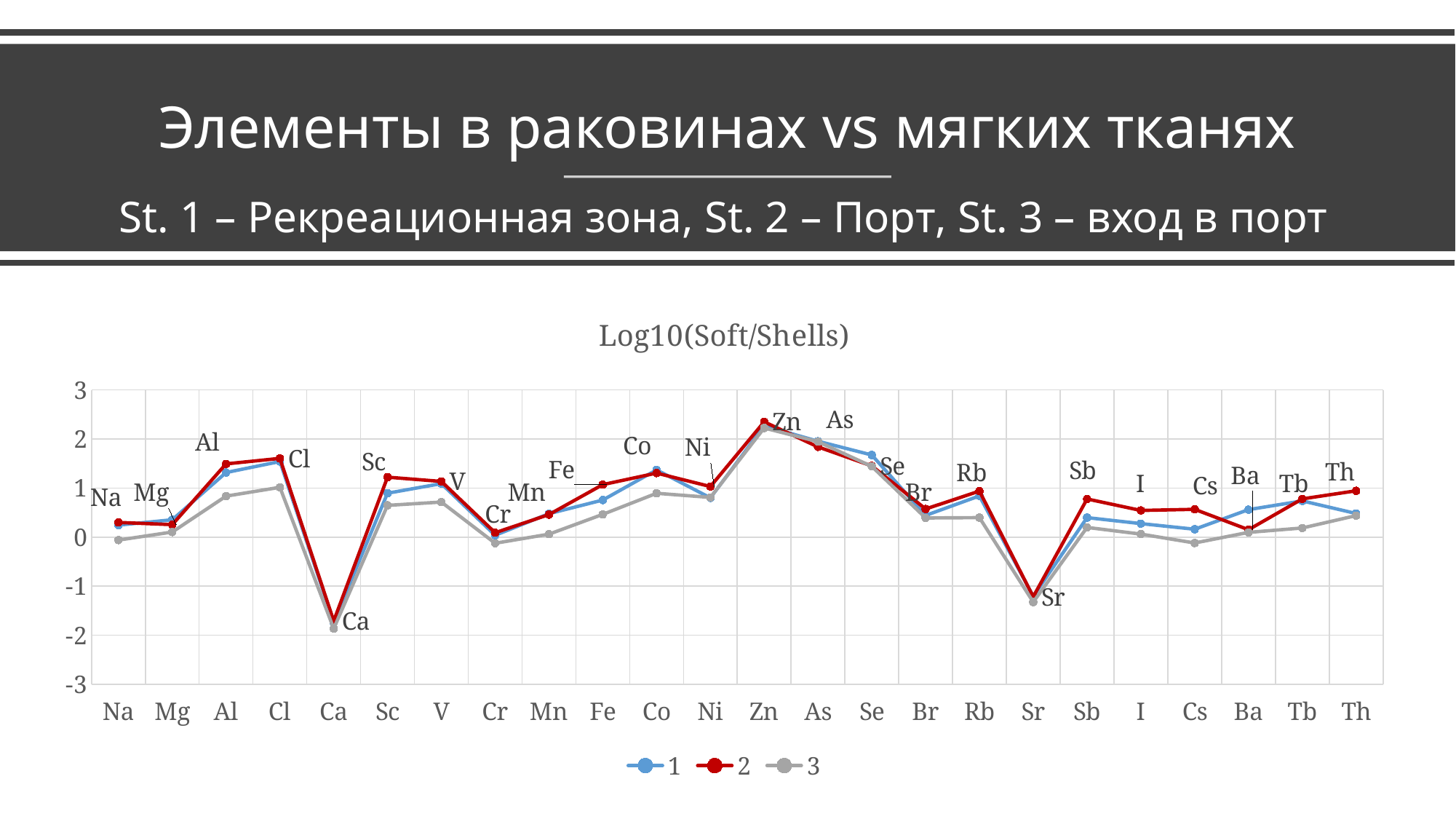
Is the value for Zn in series 1 greater or less than 2? greater Is the value for Sr in series 3 greater or less than -1? less Which element has the highest value for series 2? Zn Is the value for Ca in series 2 greater or less than -1? less What is the title of the chart? Log10(Soft/Shells) How many elements (categories) are plotted along the x axis? 24 Which colour is used for series 2? red What kind of chart is shown on the slide? line chart For Al, which series has the larger value, series 2 or series 3? series 2 How many series does the legend list? 3 Which element has the lowest value for series 3? Ca